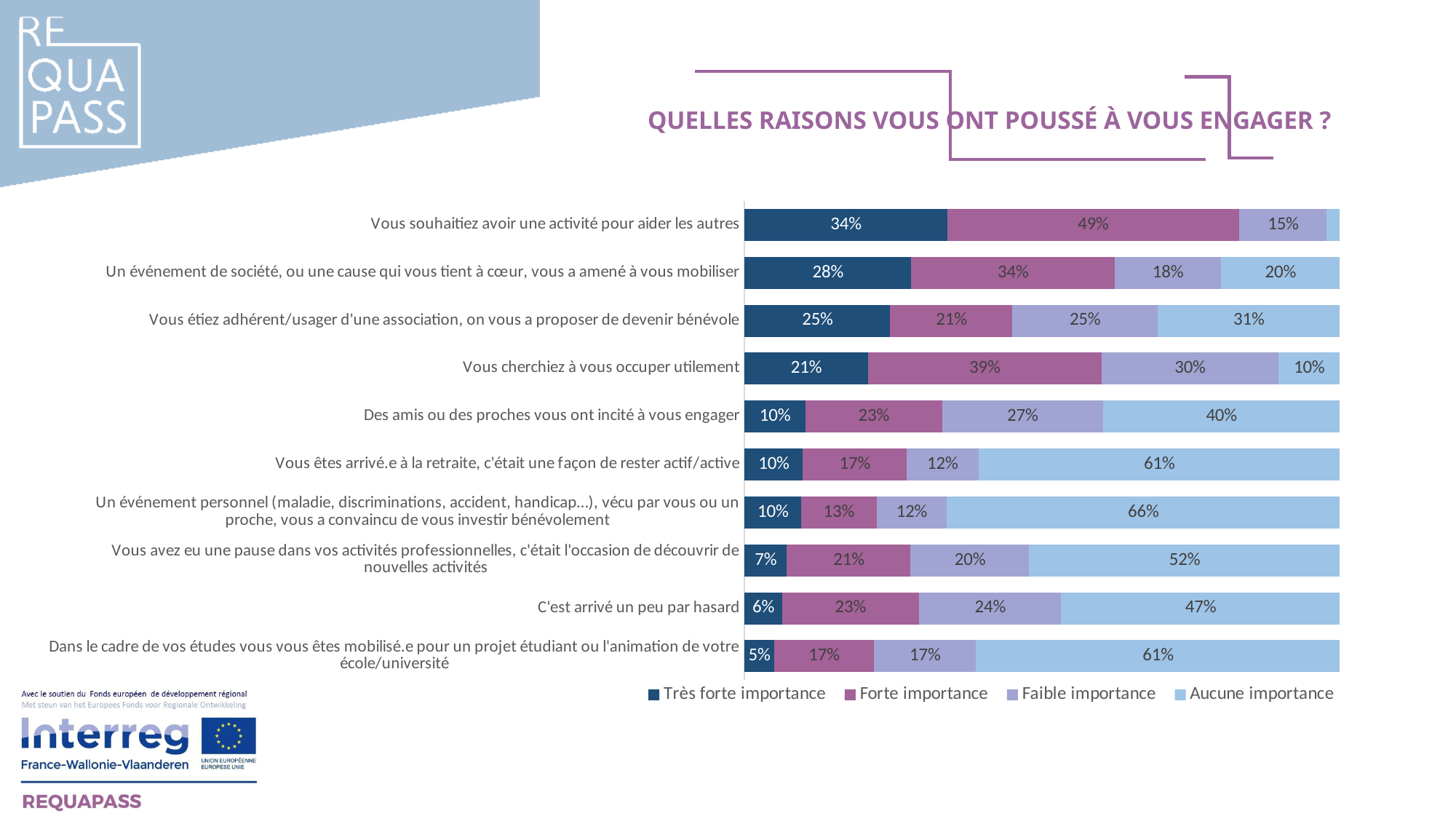
What is the 'Très forte importance' value for 'Vous souhaitiez avoir une activité pour aider les autres'? 34% What is the title of the chart? QUELLES RAISONS VOUS ONT POUSSÉ À VOUS ENGAGER ? What is the difference between the 'Aucune importance' values for 'Vous êtes arrivé.e à la retraite, c'était une façon de rester actif/active' and 'Des amis ou des proches vous ont incité à vous engager'? 21% How many categories (reasons) are plotted in the chart? 10 What is the 'Forte importance' value for 'Vous cherchiez à vous occuper utilement'? 39% Which category has the lowest 'Très forte importance' value? Dans le cadre de vos études vous vous êtes mobilisé.e pour un projet étudiant ou l'animation de votre école/université Which is larger: the 'Faible importance' value for 'Vous cherchiez à vous occuper utilement' or for 'C'est arrivé un peu par hasard'? Vous cherchiez à vous occuper utilement What is the 'Aucune importance' value for 'Un événement personnel (maladie, discriminations, accident, handicap…), vécu par vous ou un proche, vous a convaincu de vous investir bénévolement'? 66% Which category has the highest 'Très forte importance' value? Vous souhaitiez avoir une activité pour aider les autres What is the total of the stacked bar for 'Vous étiez adhérent/usager d'une association, on vous a proposer de devenir bénévole'? 102% How many series does the legend list? 4 What type of chart is shown on the slide? Stacked bar chart